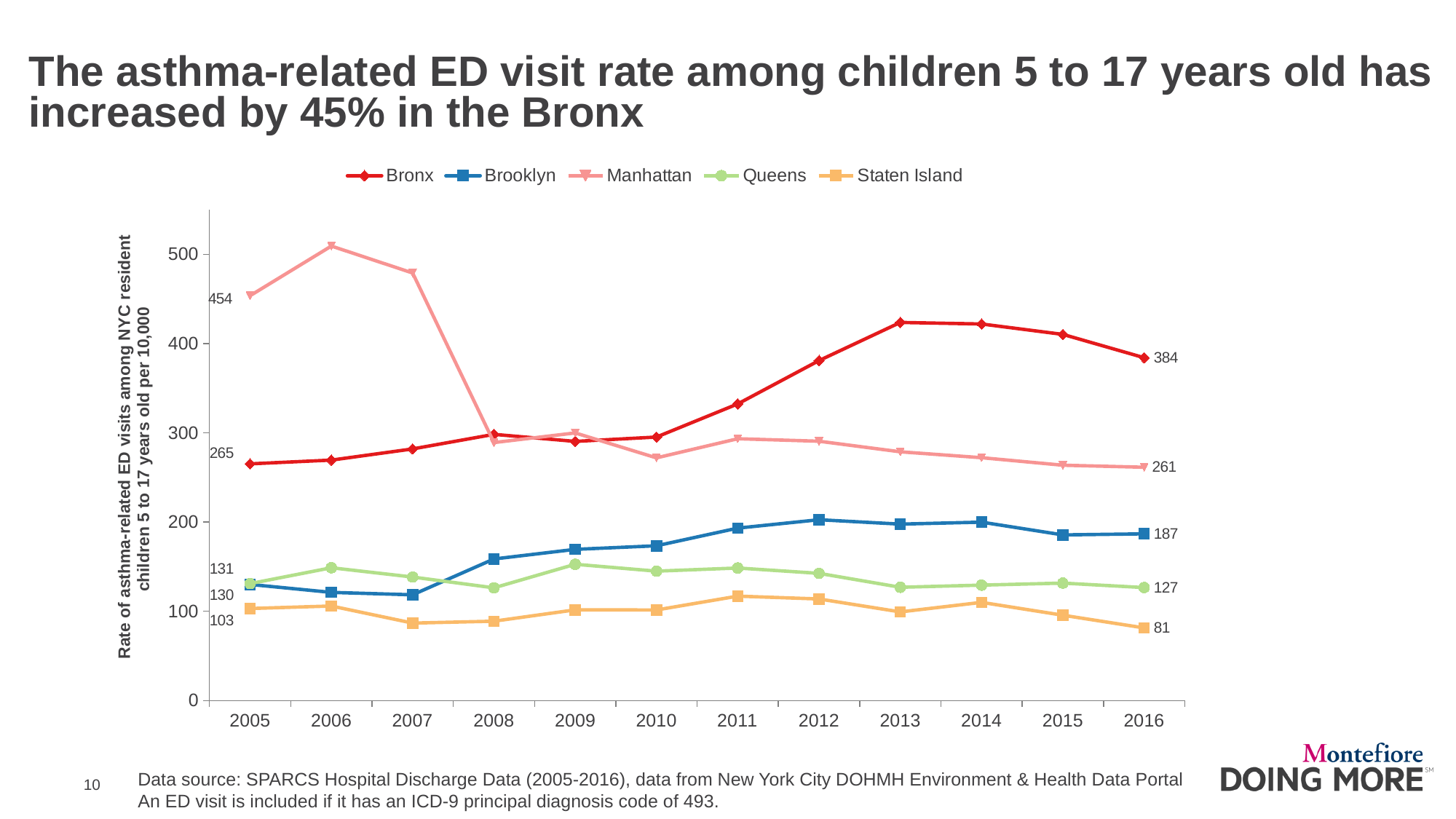
Which borough has the highest rate in 2016? Bronx How many years are shown on the x axis? 12 Is the value for Manhattan in 2006 greater or less than 500? greater By how much did the Bronx rate increase from 2005 to 2016? 119 What is the value for Brooklyn in 2016? 187 How many boroughs (series) does the legend list? 5 What is the value for the Bronx in 2005? 265 What kind of chart is shown on the slide? line chart By how much did the Manhattan rate fall from 2005 to 2016? 193 What is the asthma-related ED visit rate for Manhattan in 2005? 454 What is the value for Staten Island in 2016? 81 What is the asthma-related ED visit rate for the Bronx in 2016? 384